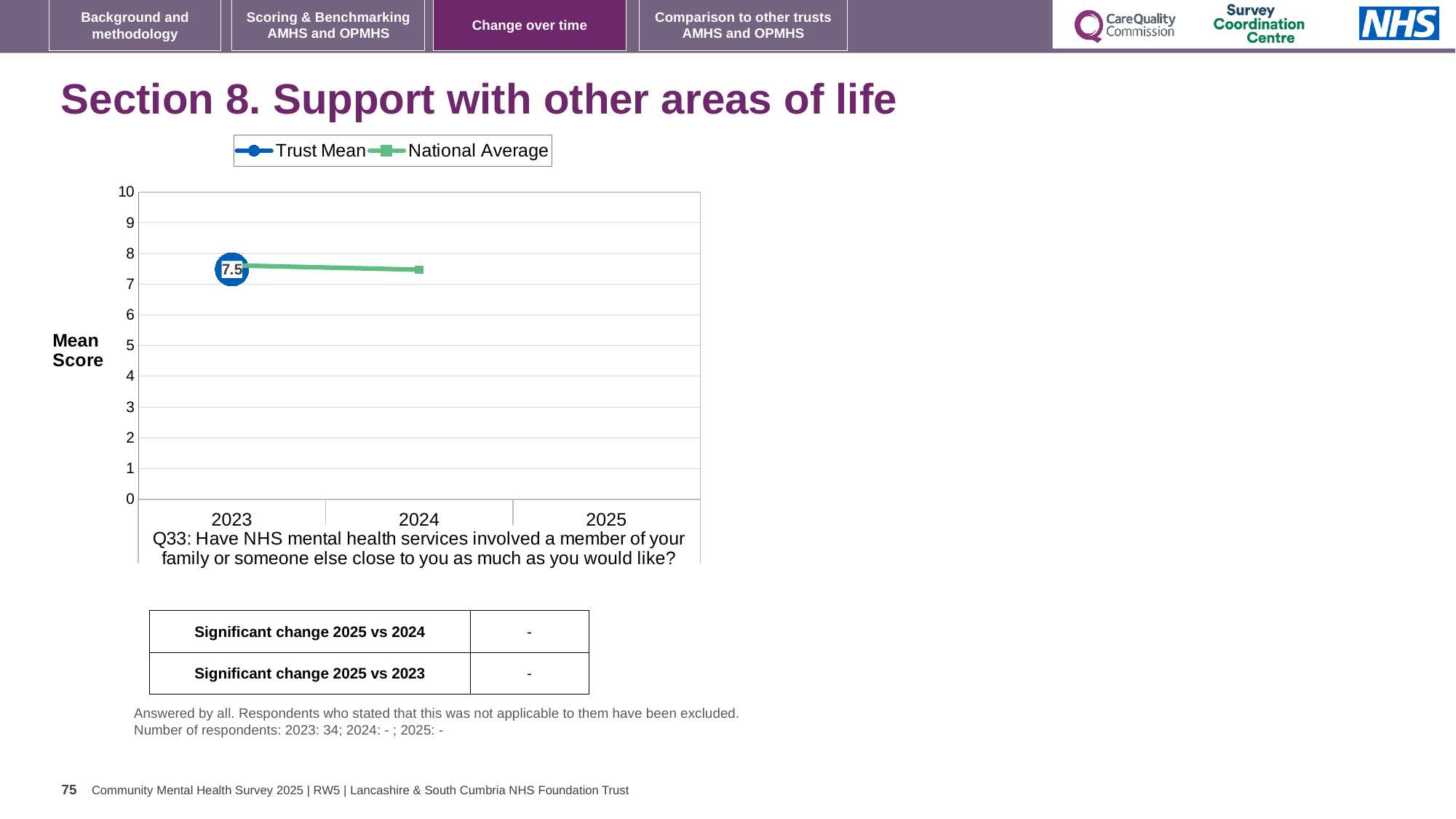
What is the Trust Mean value for 2023? 7.5 Which series is shown in blue in the chart legend? Trust Mean What kind of chart is shown on the slide? Line chart What is the label on the y axis of the chart? Mean Score Does the National Average line rise or fall from 2023 to 2024? Fall How many years are shown on the x axis of the chart? 3 Is the National Average value for 2024 greater or less than 7? greater Is the Trust Mean value for 2023 greater or less than 5? greater For which year is a Trust Mean data label shown on the chart? 2023 What is the highest value shown on the y axis of the chart? 10 Is the National Average value for 2024 greater or less than 8? less How many series does the chart legend list? 2